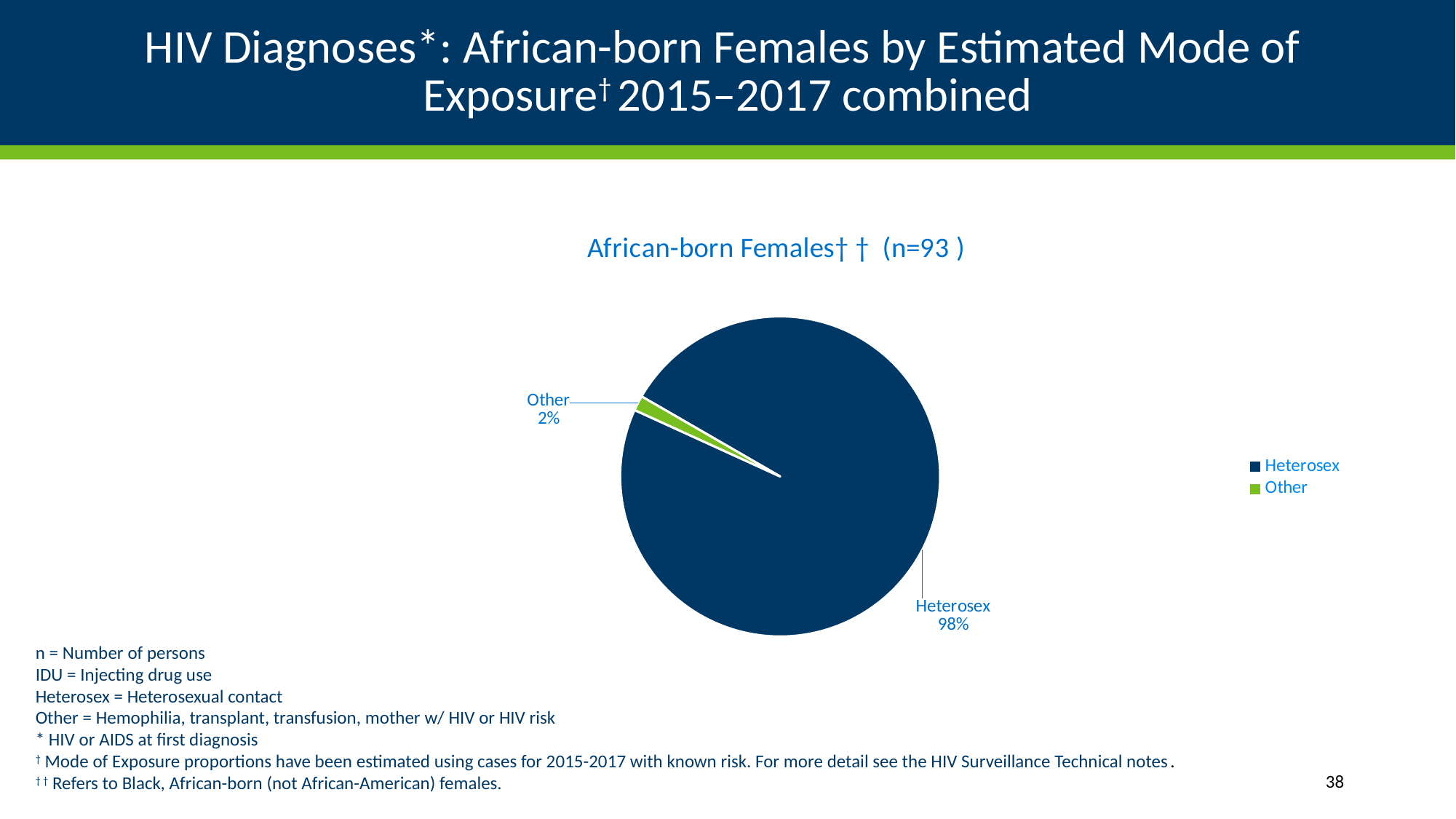
What share of the pie does Heterosex account for? 98% Which category has the smallest slice of the pie? Other How many entries does the legend list? 2 What is the value of n shown in the chart title? 93 What share of the pie does Other account for? 2% Which slice is larger, Heterosex or Other? Heterosex Which category has the largest slice of the pie? Heterosex What kind of chart is shown on the slide? pie chart How many slices does the pie chart have? 2 What colour is the Other slice in the pie chart? green What is the difference in percentage points between the Heterosex and Other slices? 96